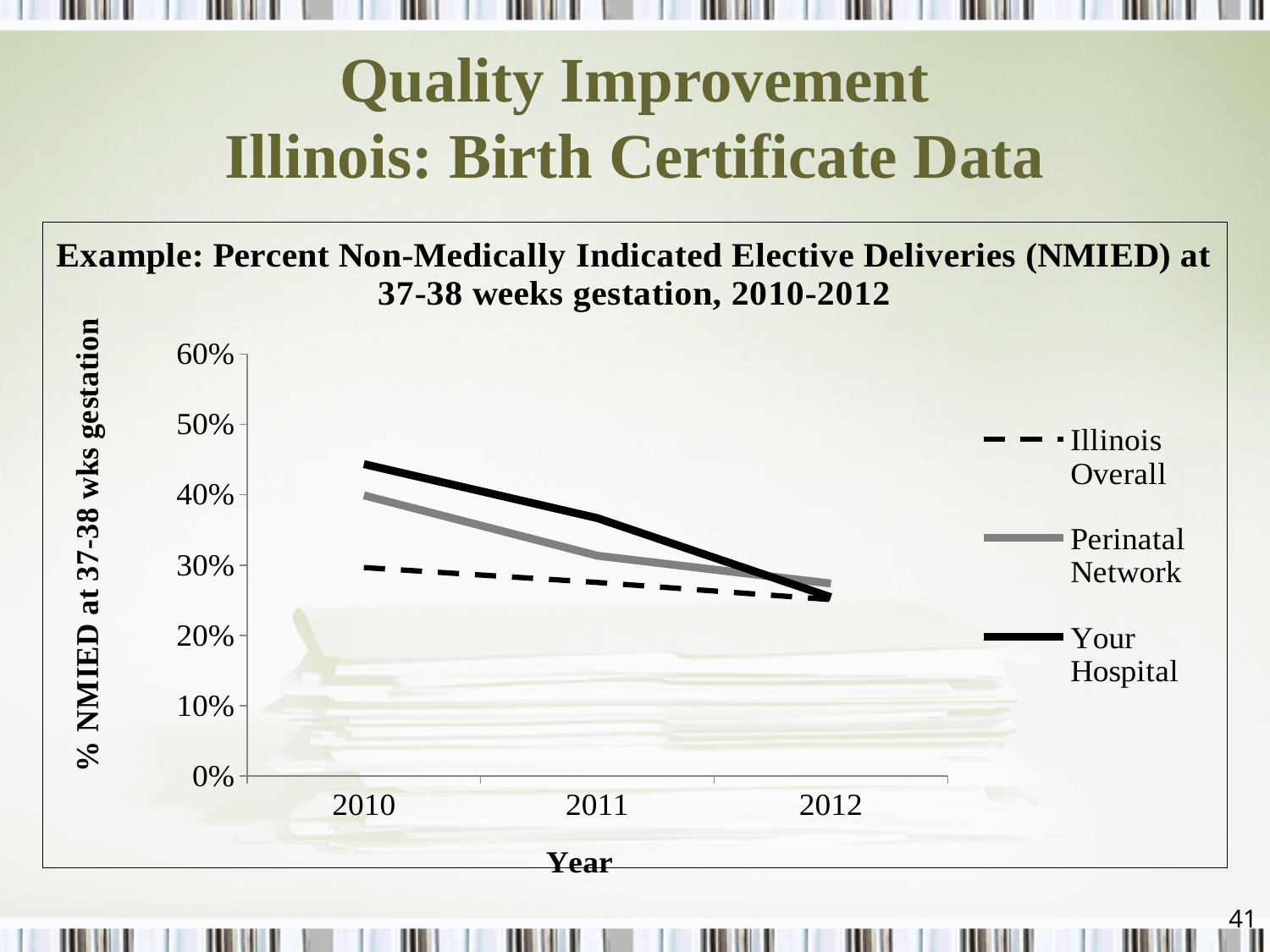
How many series does the legend list? 3 Is the value for Illinois Overall in 2011 greater or less than 40%? less Is the value for Your Hospital in 2011 greater or less than 40%? less Is the value for Your Hospital in 2012 greater or less than 30%? less Which series has the lowest value in 2010? Illinois Overall In 2011, which is larger: Your Hospital or Illinois Overall? Your Hospital What kind of chart is shown on the slide? Line chart Which series has the highest value in 2010? Your Hospital What is the title of the x axis? Year Does the Your Hospital line rise or fall from 2010 to 2012? Fall How many years are plotted along the x axis? 3